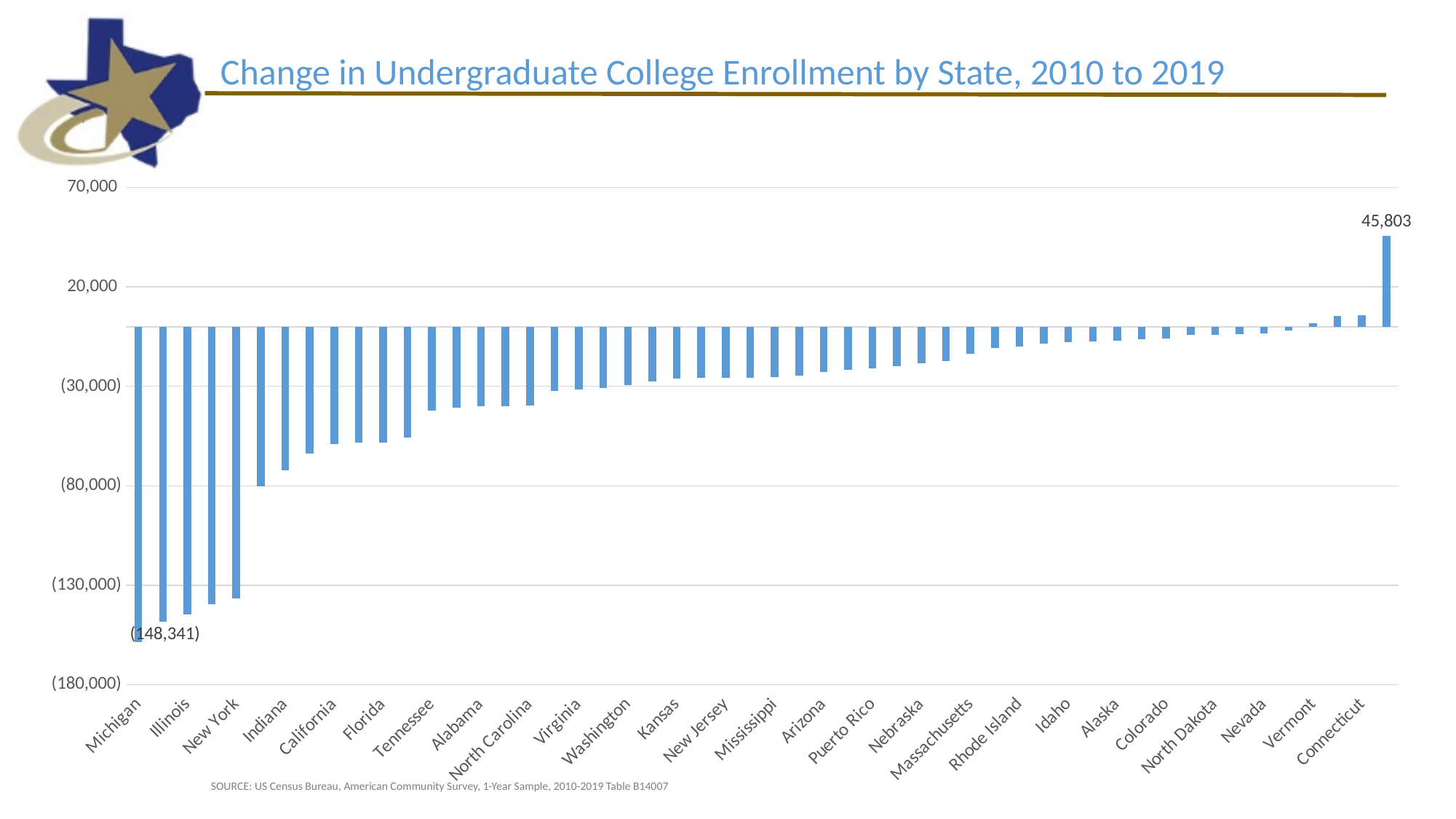
What is the title of the chart? Change in Undergraduate College Enrollment by State, 2010 to 2019 What is the largest value labeled on the chart? 45,803 Do the values generally rise or fall moving from left to right along the x axis? rise Is the value for Michigan greater or less than (130,000)? less Which has the larger decline in enrollment, Michigan or Indiana? Michigan What is the difference between the highest labeled value (45,803) and the lowest labeled value (148,341)? 194,144 Which state has the lowest value on the chart? Michigan Is the value for Nebraska greater or less than (30,000)? greater What type of chart is shown on the slide? bar chart What is the source cited below the chart? US Census Bureau, American Community Survey, 1-Year Sample, 2010-2019 Table B14007 Is the value for Florida greater or less than (30,000)? less